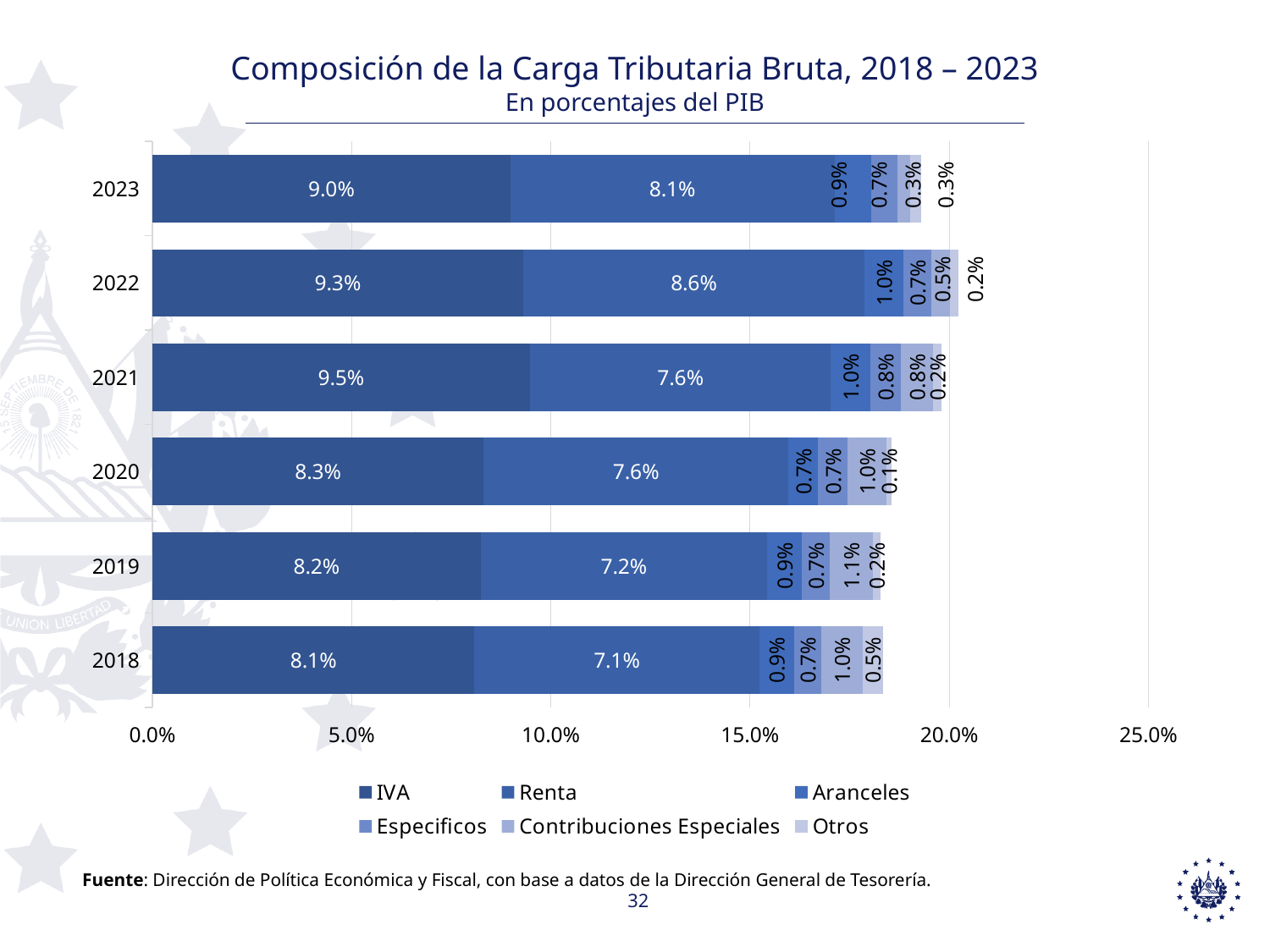
What is the Contribuciones Especiales value for 2019? 1.1% What is the difference between the IVA value in 2022 and in 2023? 0.3% How many years are shown on the chart? 6 What is the IVA value for 2023? 9.0% What kind of chart is shown on the slide? stacked bar chart What is the Renta value for 2022? 8.6% Does the IVA value rise or fall from 2018 to 2021? rise Which is larger, the Renta value for 2022 or for 2021? 2022 In which year is the IVA value highest? 2021 Is the total bar length for 2020 greater or less than 20.0%? less In which year is the Renta value lowest? 2018 How many series does the legend list? 6